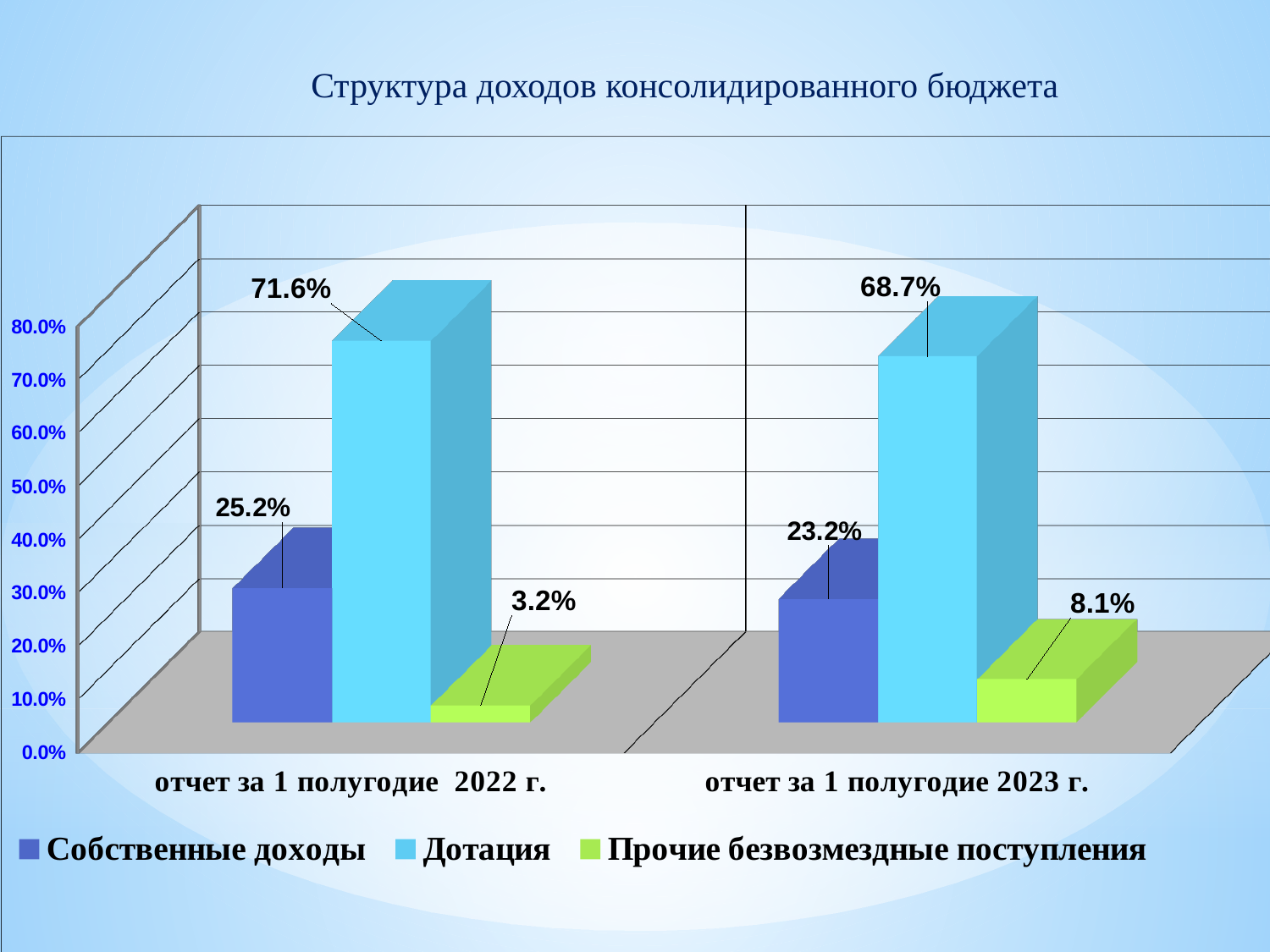
What is the title of the chart? Структура доходов консолидированного бюджета What is the difference between the Дотация values for 2022 and 2023? 2.9% What is the value for Дотация in отчет за 1 полугодие 2023 г.? 68.7% Which series has the highest value in отчет за 1 полугодие 2022 г.? Дотация How many categories are shown on the x axis? 2 What is the value for Прочие безвозмездные поступления in отчет за 1 полугодие 2022 г.? 3.2% What is the value for Собственные доходы in отчет за 1 полугодие 2023 г.? 23.2% How many series does the legend list? 3 Which series has the lowest value in отчет за 1 полугодие 2023 г.? Прочие безвозмездные поступления What kind of chart is shown on the slide? Bar chart Which is larger: Прочие безвозмездные поступления in 2022 or in 2023? 2023 What is the value for Дотация in отчет за 1 полугодие 2022 г.? 71.6%